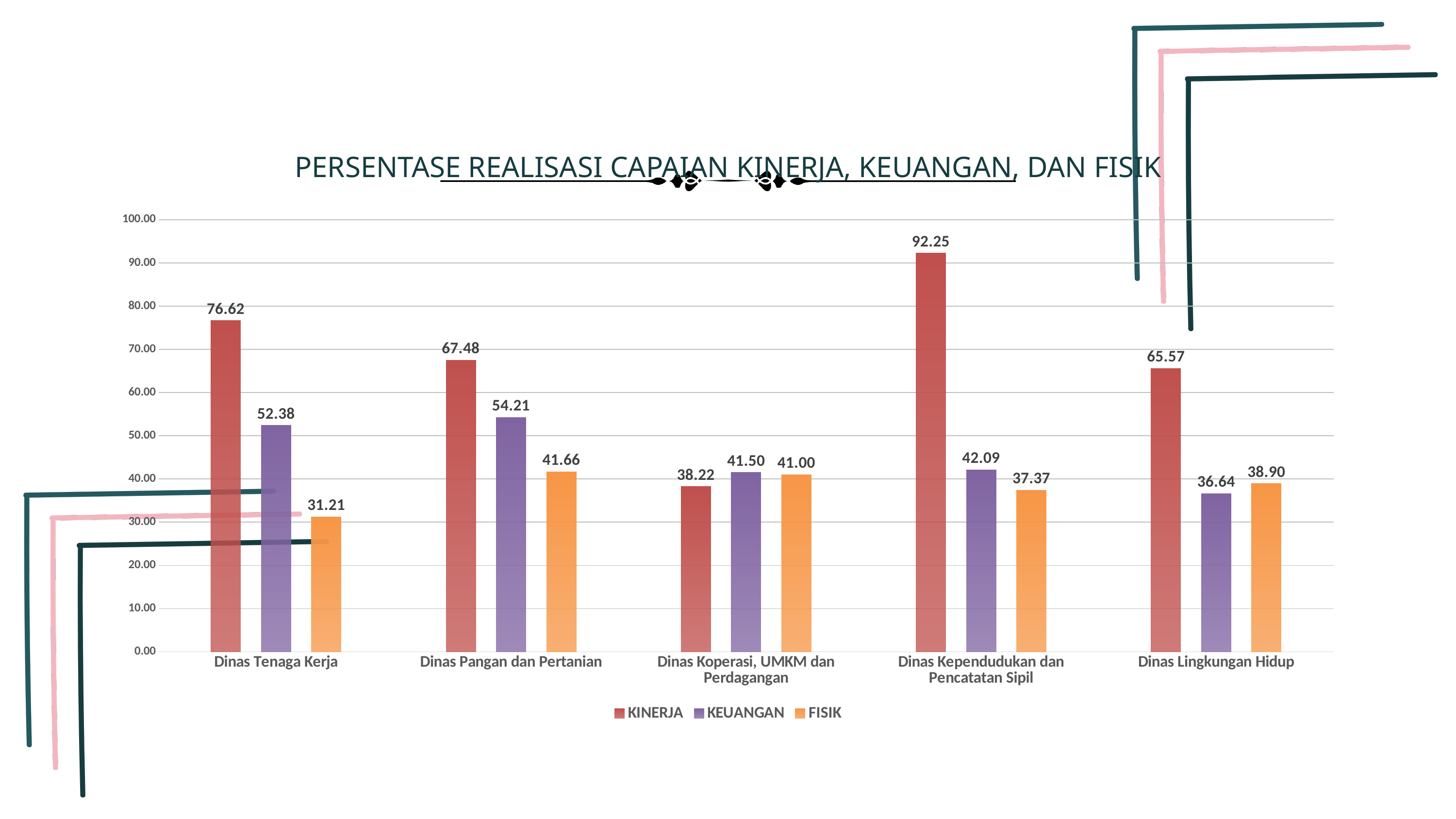
What is the difference between the KINERJA and KEUANGAN values for Dinas Tenaga Kerja? 24.24 How many categories are shown on the x axis? 5 What is the KINERJA value for Dinas Kependudukan dan Pencatatan Sipil? 92.25 Which is larger for Dinas Lingkungan Hidup, the KEUANGAN value or the FISIK value? FISIK What is the title of the chart? PERSENTASE REALISASI CAPAIAN KINERJA, KEUANGAN, DAN FISIK What is the FISIK value for Dinas Tenaga Kerja? 31.21 Which category has the lowest FISIK value? Dinas Tenaga Kerja Which category has the highest KINERJA value? Dinas Kependudukan dan Pencatatan Sipil What kind of chart is shown on the slide? Bar chart Which category has the lowest KINERJA value? Dinas Koperasi, UMKM dan Perdagangan How many series does the legend list? 3 What is the KEUANGAN value for Dinas Pangan dan Pertanian? 54.21